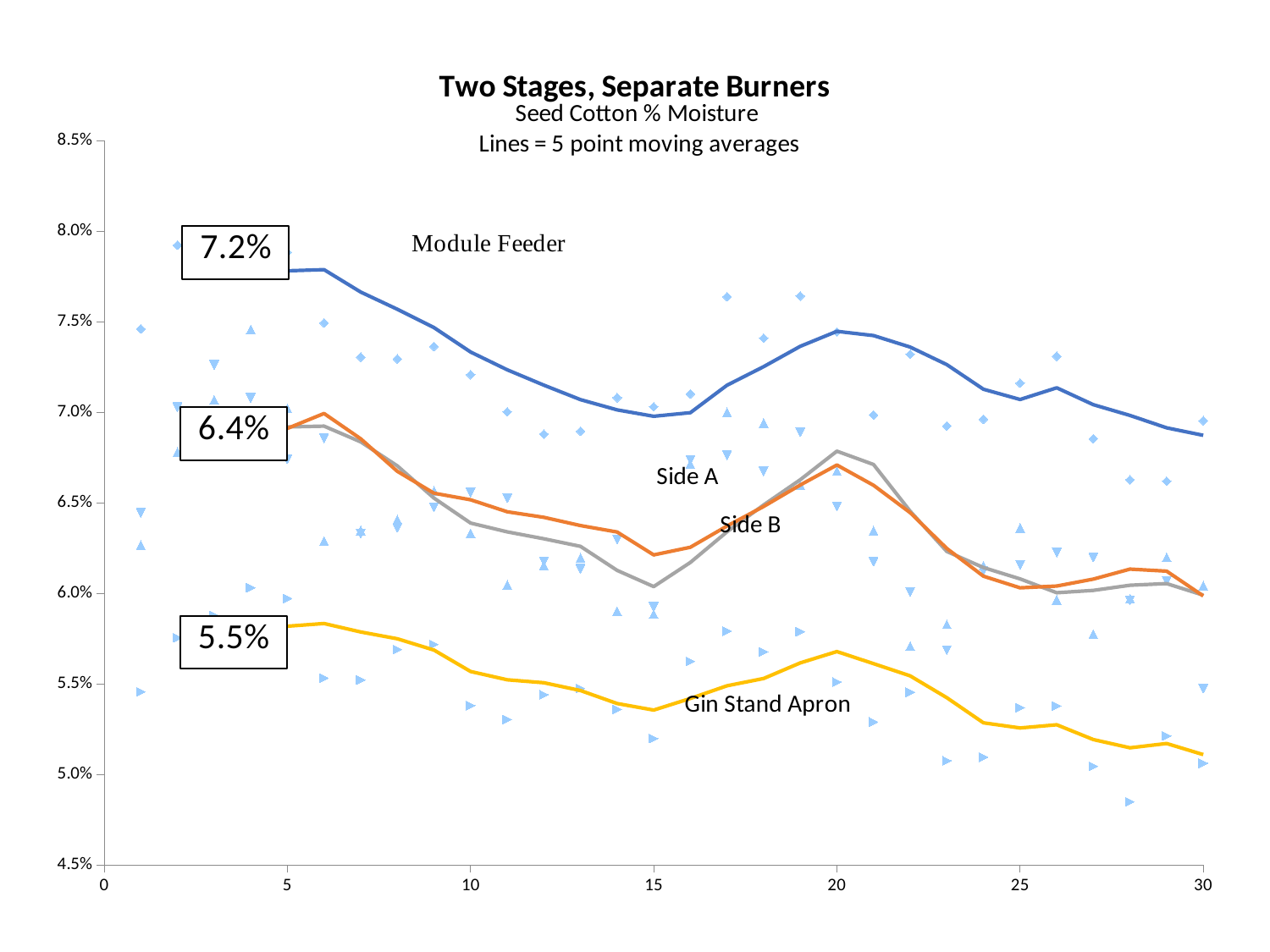
What is the title of the chart? Two Stages, Separate Burners What kind of chart is shown on the slide? scatter chart with moving-average lines Which labeled line sits lowest on the chart? Gin Stand Apron What value is printed in the box next to the Gin Stand Apron line? 5.5% Which labeled line sits highest on the chart? Module Feeder Does the Module Feeder line rise or fall between x = 5 and x = 15? fall What value is printed in the box next to the Module Feeder line? 7.2% Is the Gin Stand Apron line at x = 30 greater or less than 5.5%? less According to the chart's subtitle, what do the lines represent? 5 point moving averages How many labeled moving-average lines are plotted on the chart? 4 What value is printed in the box next to the Side A and Side B lines? 6.4% Is the Module Feeder line at x = 20 greater or less than 7.0%? greater